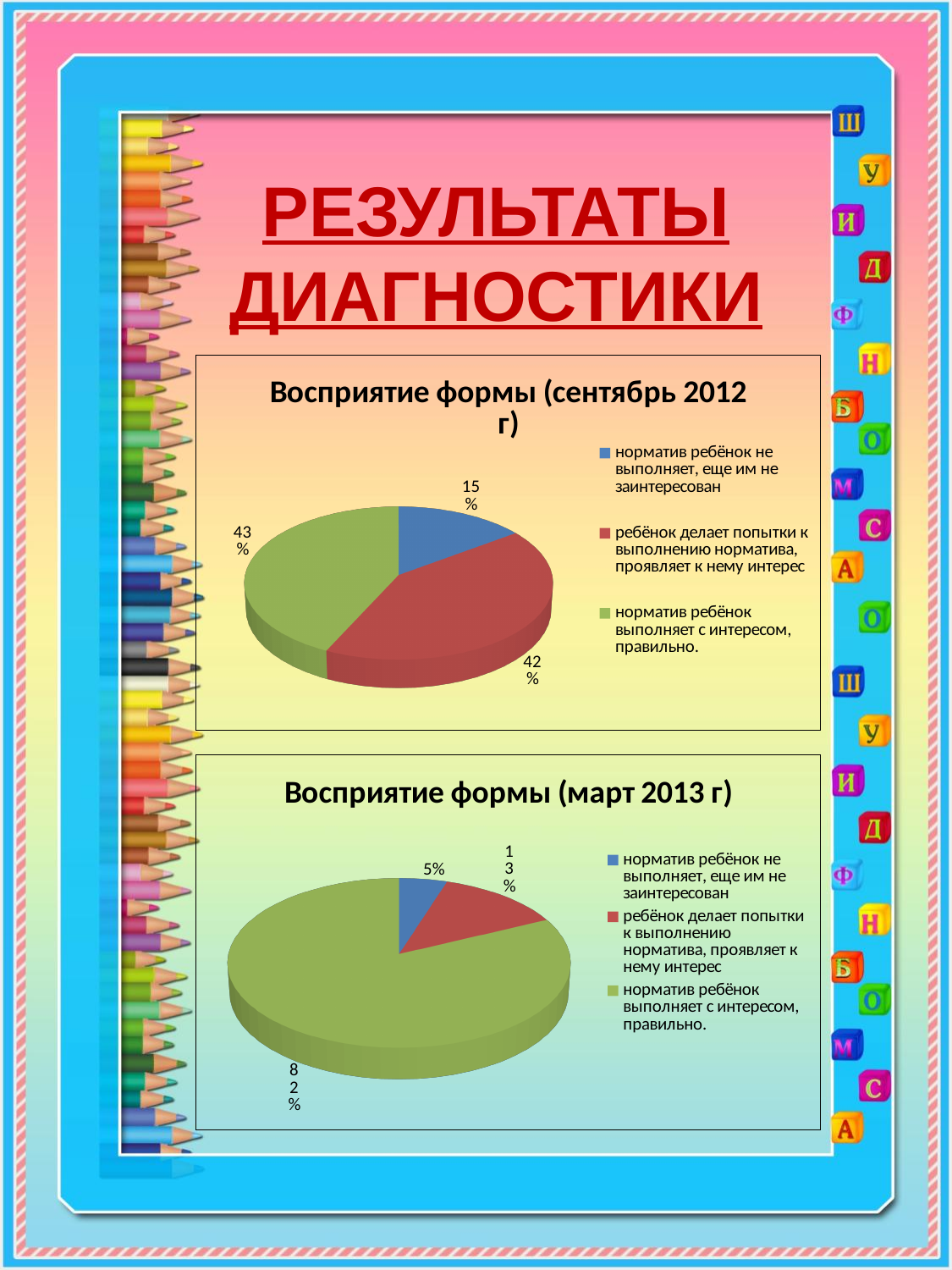
In the chart titled "Восприятие формы (март 2013 г)", which category has the smallest share? норматив ребёнок не выполняет, еще им не заинтересован In the chart titled "Восприятие формы (март 2013 г)", what is the difference in percentage points between the largest and smallest slices? 77 In the chart titled "Восприятие формы (март 2013 г)", what percentage is shown for "ребёнок делает попытки к выполнению норматива, проявляет к нему интерес"? 13% In the chart titled "Восприятие формы (сентябрь 2012 г)", what percentage is shown for "норматив ребёнок не выполняет, еще им не заинтересован"? 15% How many categories does the legend of the chart titled "Восприятие формы (март 2013 г)" list? 3 In the chart titled "Восприятие формы (сентябрь 2012 г)", which category has the smallest share? норматив ребёнок не выполняет, еще им не заинтересован In the chart titled "Восприятие формы (сентябрь 2012 г)", what percentage is shown for "норматив ребёнок выполняет с интересом, правильно"? 43% What type of chart is the chart titled "Восприятие формы (сентябрь 2012 г)"? Pie chart In the chart titled "Восприятие формы (март 2013 г)", what percentage is shown for "норматив ребёнок выполняет с интересом, правильно"? 82% In the chart titled "Восприятие формы (сентябрь 2012 г)", what percentage is shown for "ребёнок делает попытки к выполнению норматива, проявляет к нему интерес"? 42% In the chart titled "Восприятие формы (март 2013 г)", which category has the largest share? норматив ребёнок выполняет с интересом, правильно In the chart titled "Восприятие формы (март 2013 г)", what percentage is shown for "норматив ребёнок не выполняет, еще им не заинтересован"? 5%